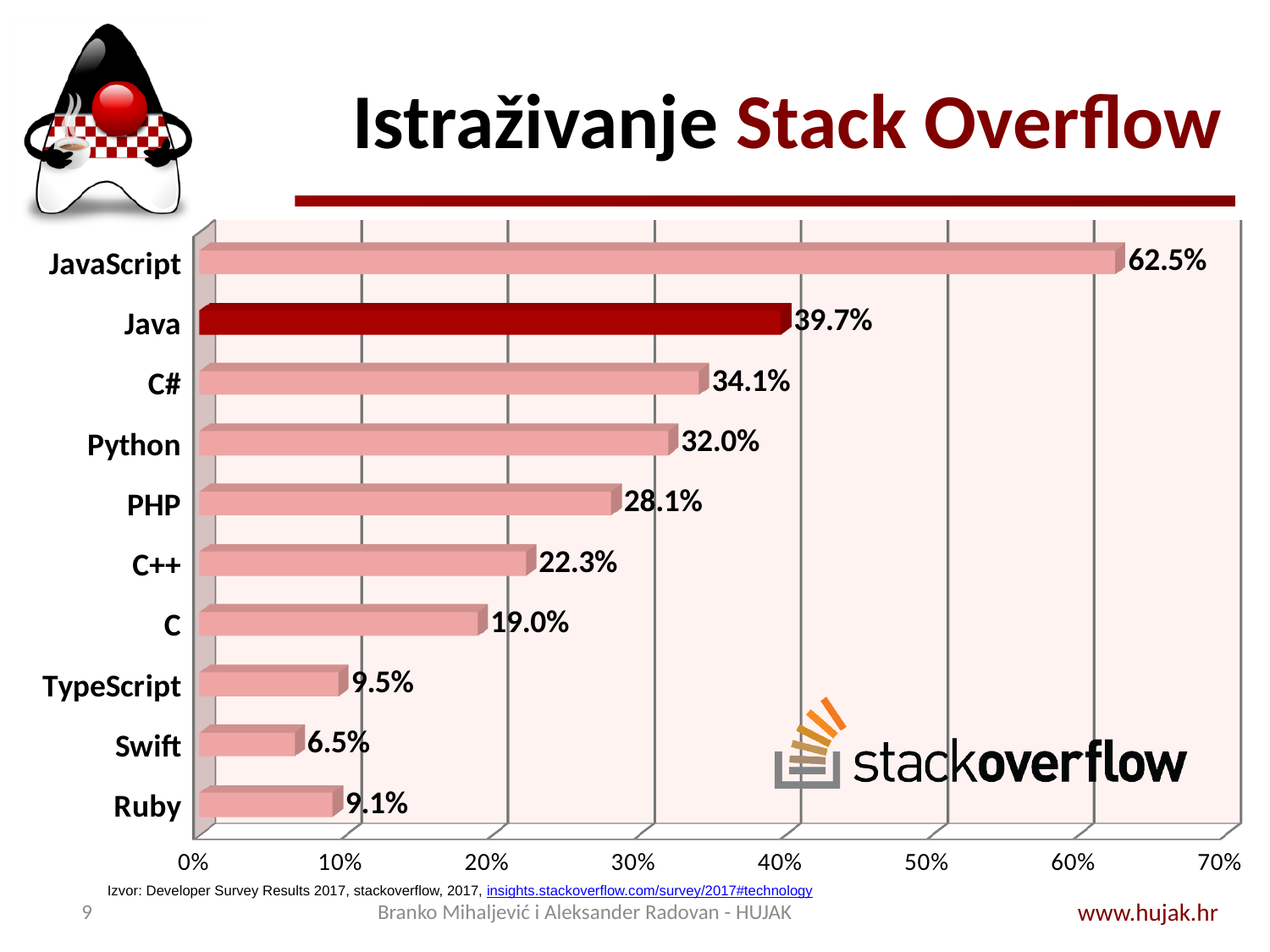
What is the value for Python? 32.0% What kind of chart is shown on the slide? bar chart What is the difference between the values for C# and Python? 2.1% What is the value for TypeScript? 9.5% Is the value for C greater or less than 20%? less What is the value for Java? 39.7% How many languages are shown in the chart? 10 Which has a larger value, PHP or C++? PHP Which bar is drawn in a darker red colour than the others? Java What is the difference between the values for JavaScript and Java? 22.8% Which language has the lowest value? Swift Which language has the highest value? JavaScript